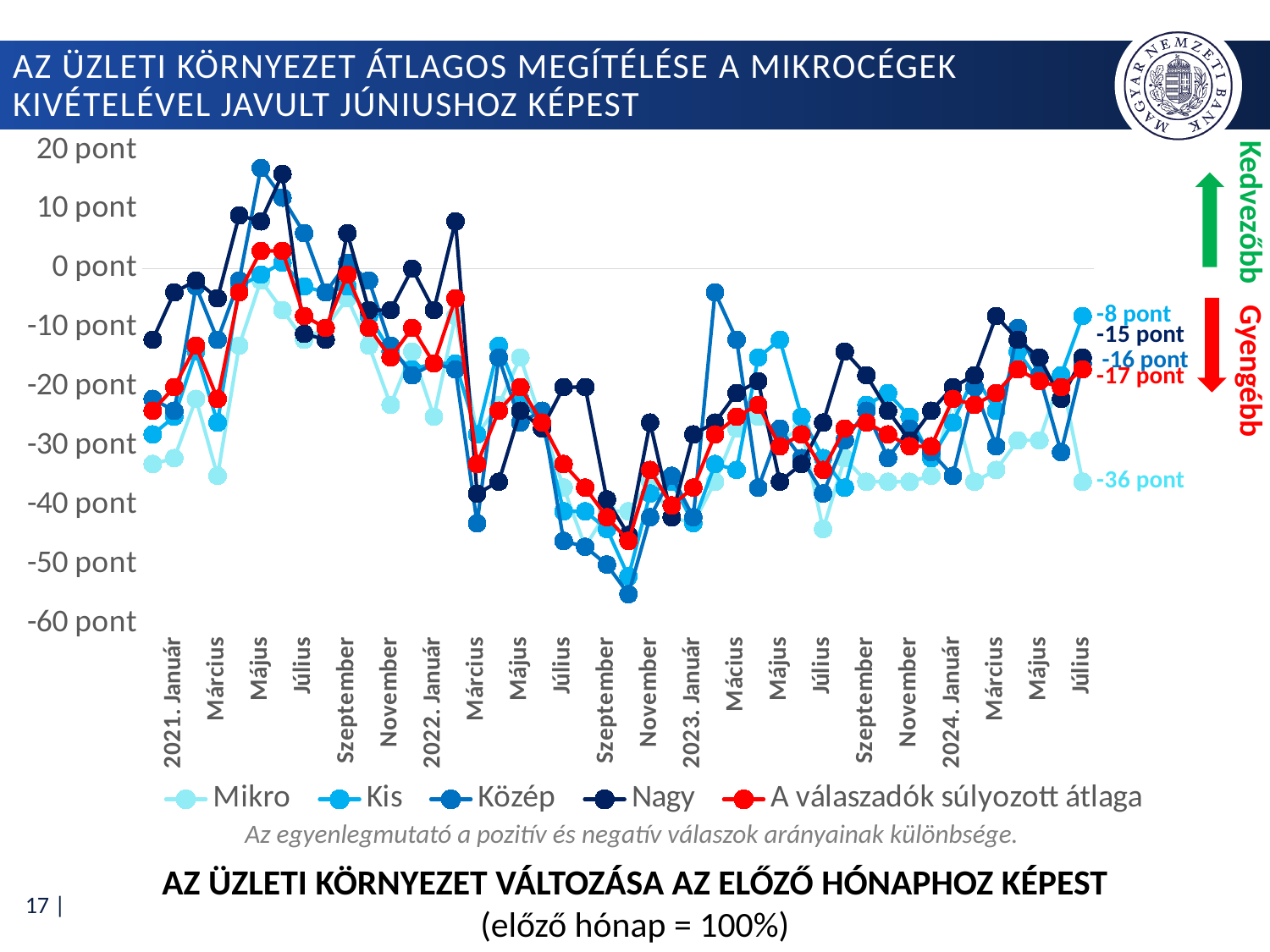
At the last point (2024 Július), what is the difference between the Kis value and the Mikro value? 28 pont Is the value of the Mikro series at 2021. Január greater or less than -30 pont? less Which series has the lowest value at the last point (2024 Július)? Mikro What is the value of the Mikro series at the last point (2024 Július)? -36 pont What is the value of 'A válaszadók súlyozott átlaga' at the last point (2024 Július)? -17 pont What is the value of the Kis series at the last point (2024 Július)? -8 pont What kind of chart is shown on the slide? line chart How many series does the legend list? 5 What is the value of the Nagy series at the last point (2024 Július)? -15 pont Which series has the highest value at the last point (2024 Július)? Kis At the last point (2024 Július), which is higher: the Nagy series or the Közép series? Nagy What is the value of the Közép series at the last point (2024 Július)? -16 pont